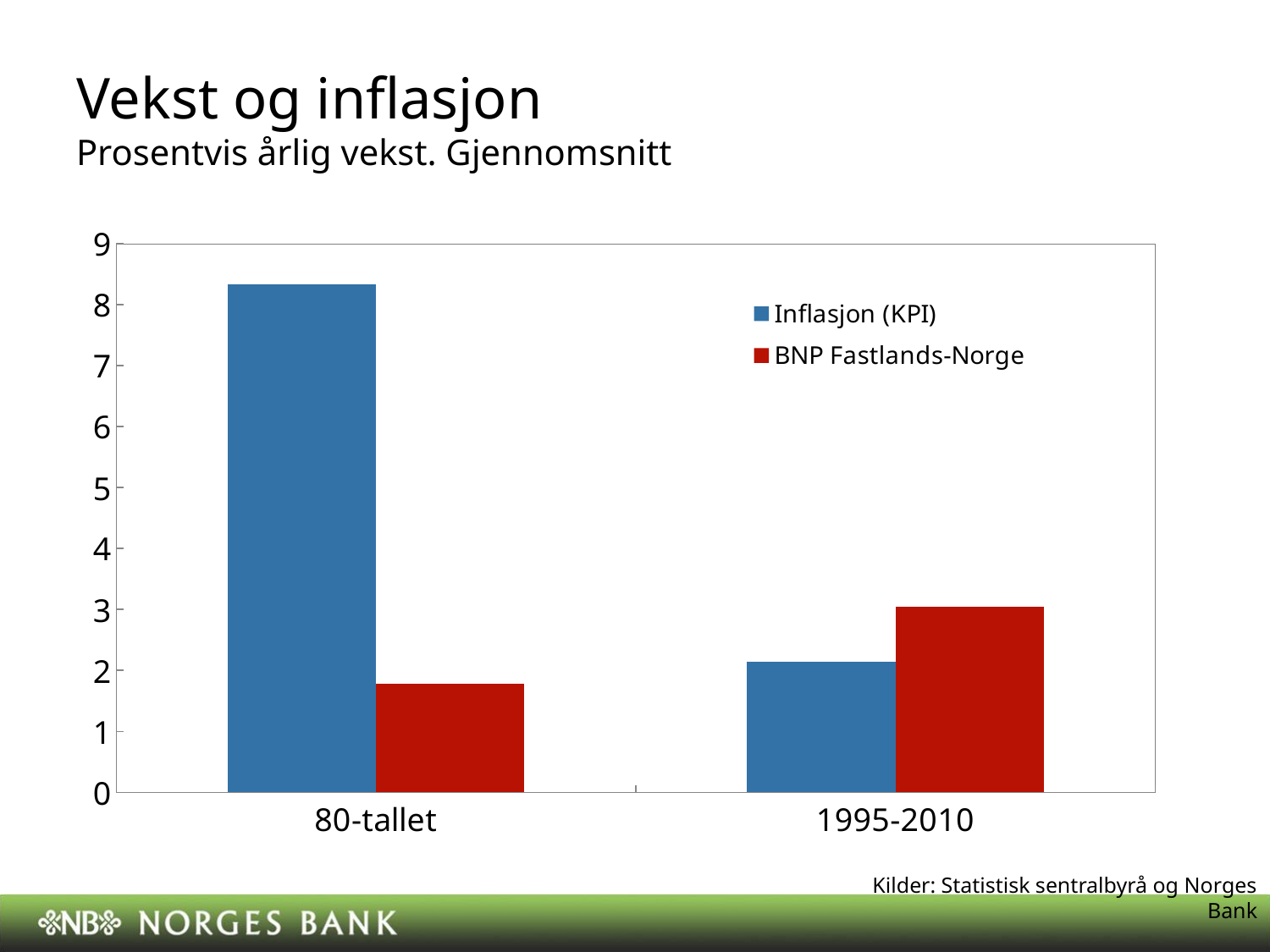
How many series does the legend list? 2 For 1995-2010, which is larger: Inflasjon (KPI) or BNP Fastlands-Norge? BNP Fastlands-Norge What colour are the BNP Fastlands-Norge bars? red Does Inflasjon (KPI) rise or fall from 80-tallet to 1995-2010? fall What type of chart is shown on the slide? bar chart How many categories are shown on the x axis? 2 Is the value for Inflasjon (KPI) in 1995-2010 greater or less than 3? less Is the value for Inflasjon (KPI) in 80-tallet greater or less than 7? greater Which series has the highest value in the chart? Inflasjon (KPI) Is the value for BNP Fastlands-Norge in 80-tallet greater or less than 2? less Which bar is the lowest in the chart? BNP Fastlands-Norge for 80-tallet For 80-tallet, which is larger: Inflasjon (KPI) or BNP Fastlands-Norge? Inflasjon (KPI)